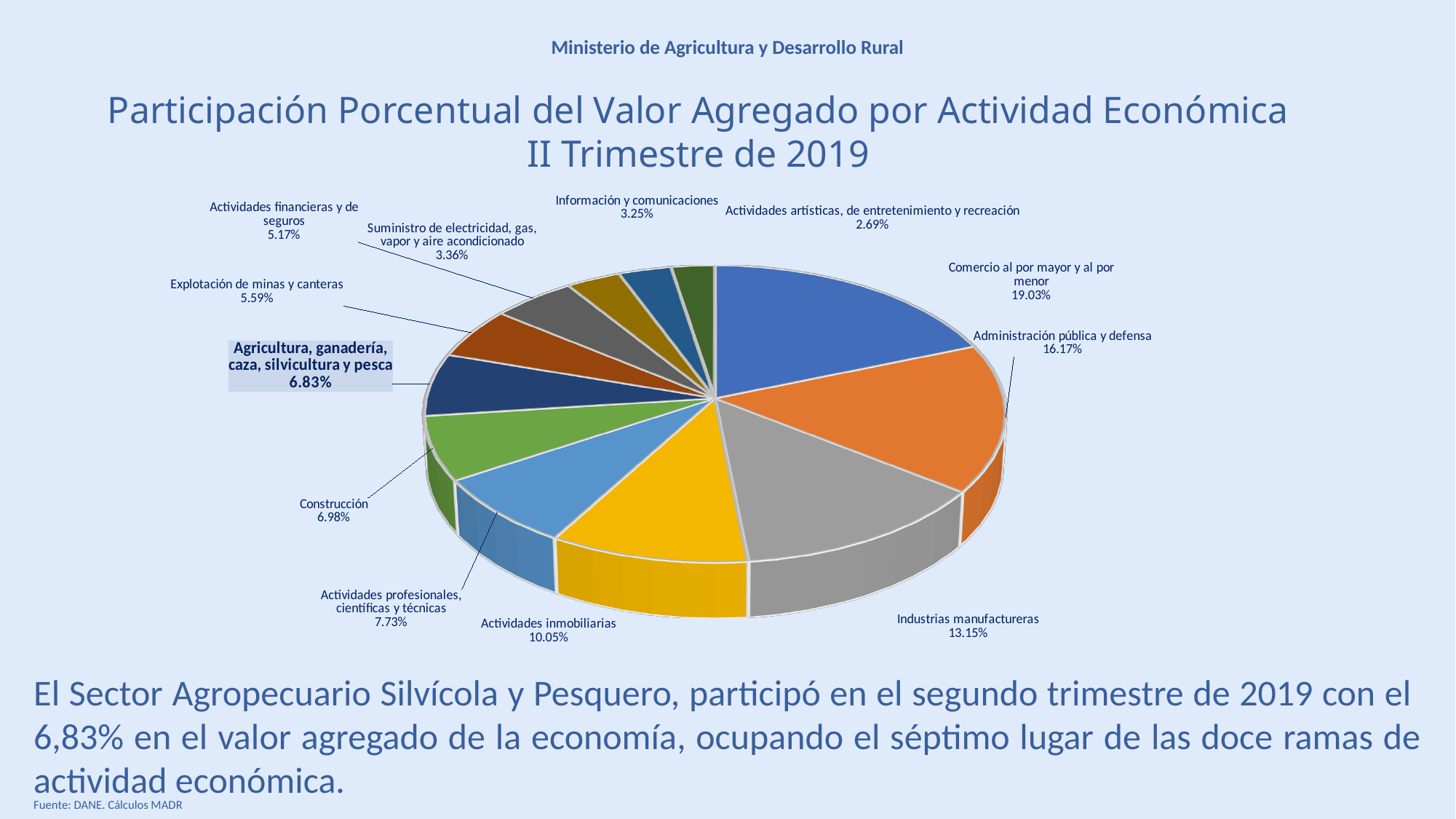
How many slices (economic activities) does the pie chart have? 12 What is the difference in percentage points between Actividades inmobiliarias and Actividades profesionales, científicas y técnicas? 2.32 Which economic activity has the smallest share of the pie? Actividades artísticas, de entretenimiento y recreación Which has a larger share: Construcción or Agricultura, ganadería, caza, silvicultura y pesca? Construcción What kind of chart is shown on the slide? Pie chart Which economic activity has the largest share of the pie? Comercio al por mayor y al por menor What is the percentage share for Agricultura, ganadería, caza, silvicultura y pesca? 6.83% What is the percentage share for Actividades profesionales, científicas y técnicas? 7.73% What is the difference in percentage points between Comercio al por mayor y al por menor and Administración pública y defensa? 2.86 What is the percentage share for Comercio al por mayor y al por menor? 19.03% What is the percentage share for Industrias manufactureras? 13.15% What is the title of the chart? Participación Porcentual del Valor Agregado por Actividad Económica II Trimestre de 2019